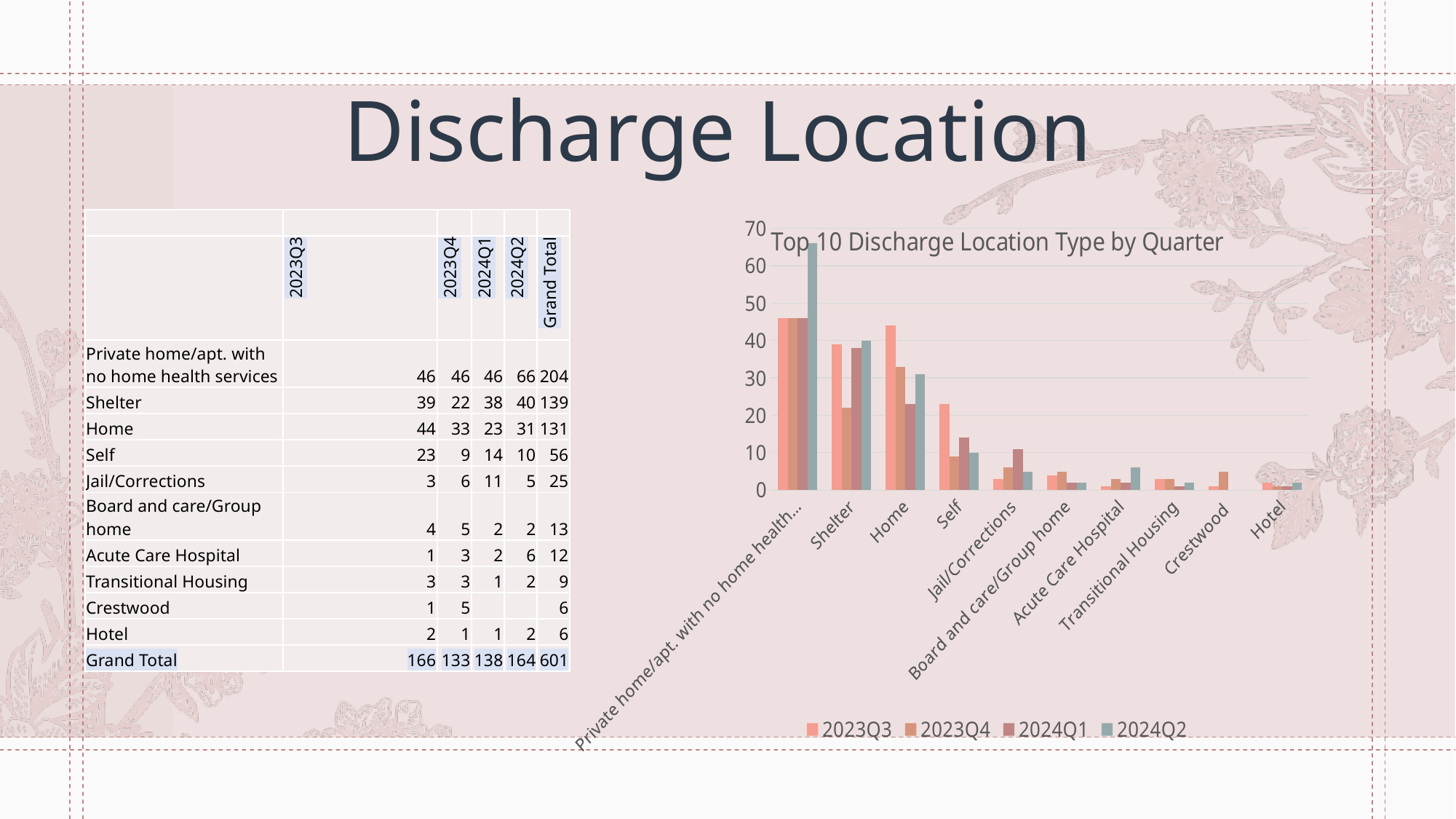
Is the 2024Q2 value for Private home/apt. with no home health services greater or less than 60? greater In the chart, what is the 2024Q2 value for Shelter? 40 What is the title of the chart on the slide? Top 10 Discharge Location Type by Quarter How many discharge location categories are shown on the x axis of the chart? 10 In the chart, what is the 2024Q1 value for Jail/Corrections? 11 What is the difference between the 2023Q3 and 2024Q1 values for Home? 21 For Home, which quarter has the lowest value in the chart? 2024Q1 Which category has the tallest bar in the chart? Private home/apt. with no home health services How many series does the legend of the "Top 10 Discharge Location Type by Quarter" chart list? 4 What kind of chart is "Top 10 Discharge Location Type by Quarter"? bar chart In the chart, what is the 2024Q2 value for Acute Care Hospital? 6 In 2023Q3, which is larger: Shelter or Home? Home